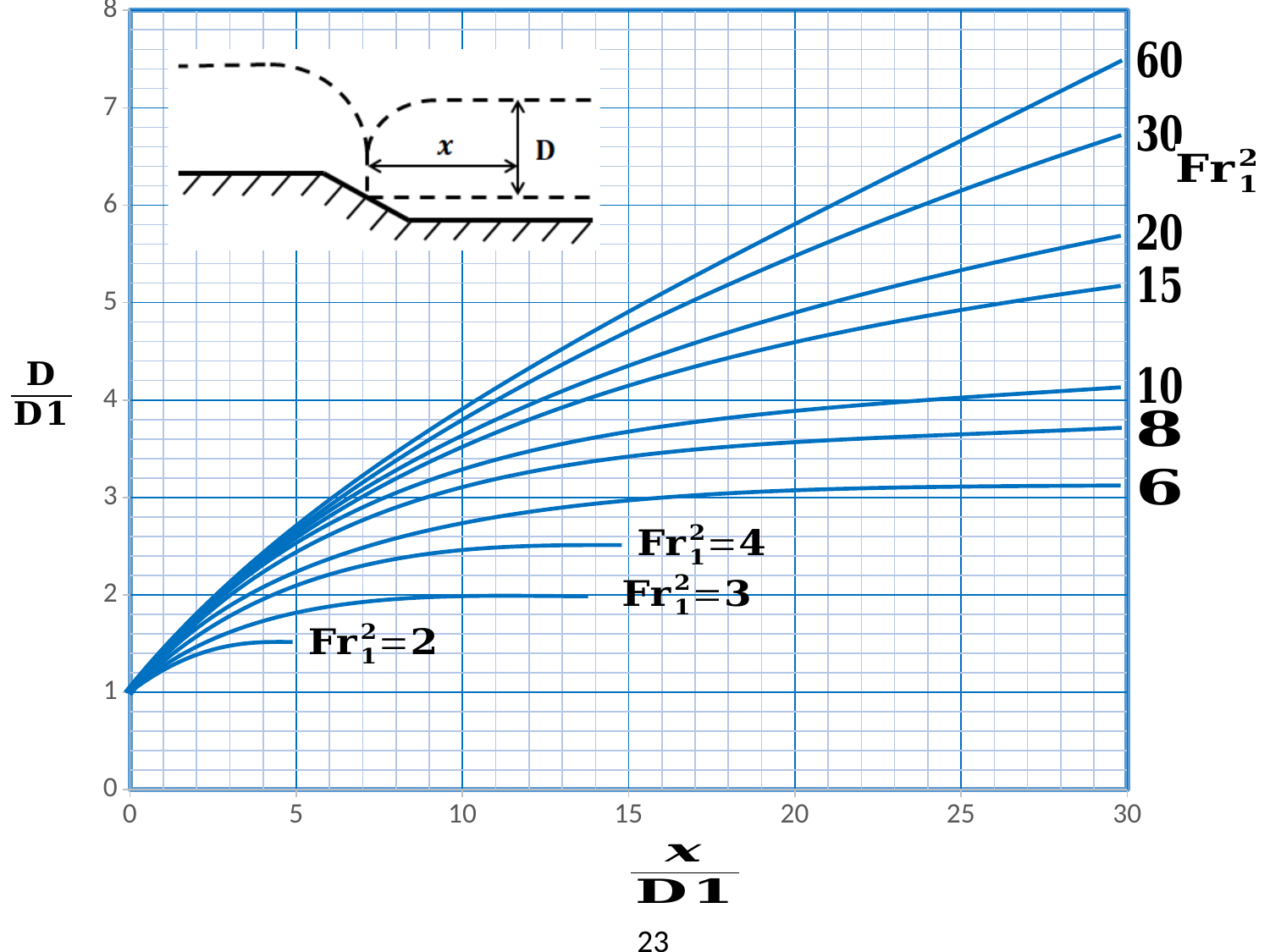
What is the value of D/D1 at x/D1 = 0, where all the curves start? 1 What is the label of the horizontal axis of the chart? x/D1 Is the D/D1 value of the Fr1² = 30 curve at x/D1 = 30 greater or less than 6? greater Is the D/D1 value of the Fr1² = 6 curve at x/D1 = 30 greater or less than 4? less At x/D1 = 30, which curve has the larger D/D1 value, Fr1² = 20 or Fr1² = 8? Fr1² = 20 Is the D/D1 value at which the Fr1² = 2 curve levels off greater or less than 2? less Do the D/D1 values of the Fr1² = 60 curve rise or fall as x/D1 increases? rise How many Fr1² curves are plotted on the chart? 10 What kind of chart is shown on the slide? line chart Which Fr1² curve reaches the highest D/D1 value at x/D1 = 30? Fr1² = 60 Which Fr1² curve has the lowest D/D1 values on the chart? Fr1² = 2